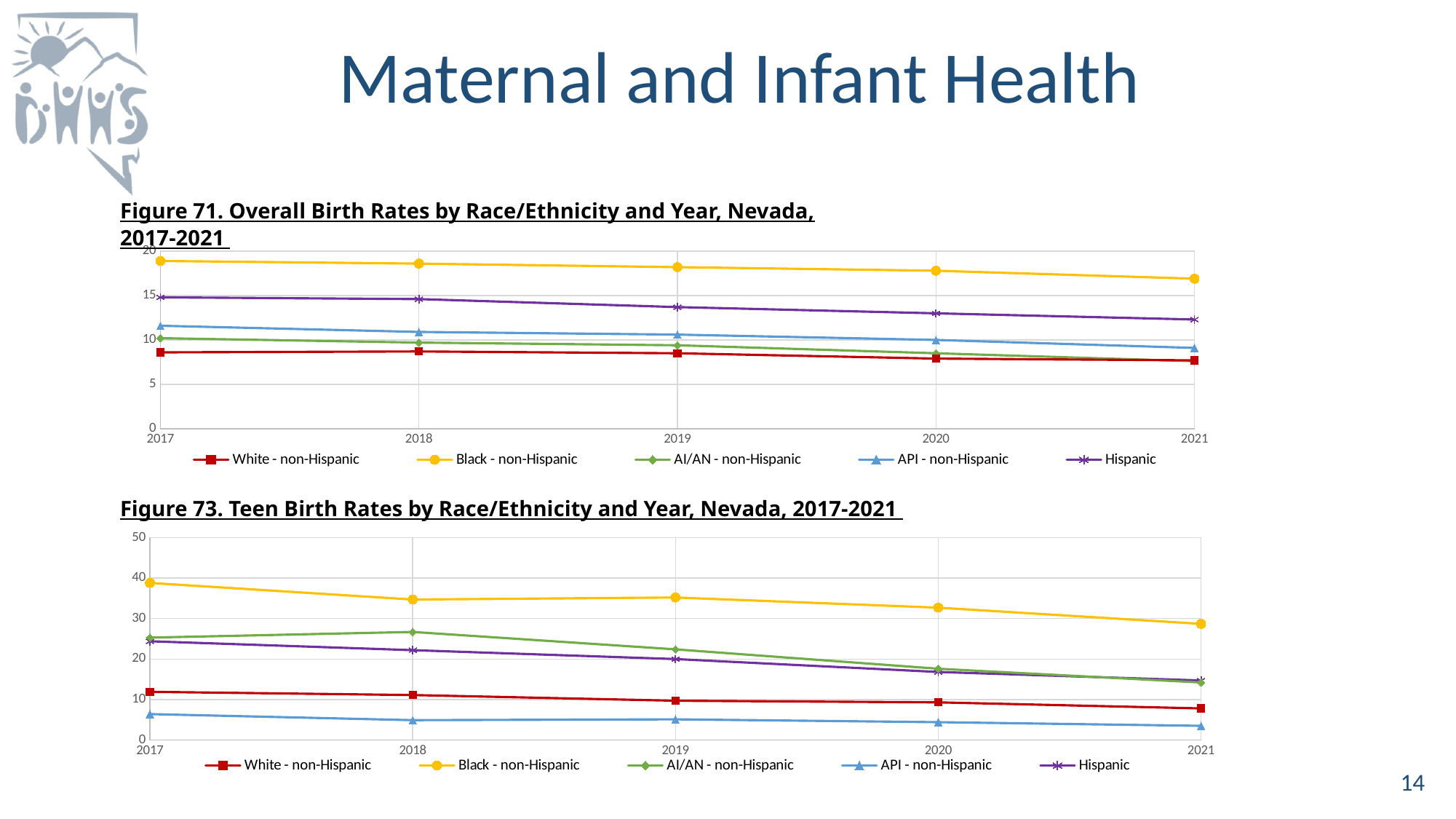
In Figure 71, which race/ethnicity group has the lowest birth rate in 2017? White - non-Hispanic What is the title of the lower chart on the slide? Figure 73. Teen Birth Rates by Race/Ethnicity and Year, Nevada, 2017-2021 What kind of chart is Figure 71? line chart In Figure 71, is the value for Black - non-Hispanic in 2017 greater or less than 15? greater How many series does the legend of Figure 73 list? 5 In Figure 73, which race/ethnicity group has the lowest teen birth rate in 2020? API - non-Hispanic In Figure 71, does the Hispanic birth rate rise or fall from 2017 to 2021? fall In Figure 71, which race/ethnicity group has the highest birth rate in 2019? Black - non-Hispanic In Figure 73, which is larger in 2018: the value for AI/AN - non-Hispanic or the value for White - non-Hispanic? AI/AN - non-Hispanic In Figure 71, is the value for API - non-Hispanic in 2021 greater or less than 10? less How many years are shown on the x axis of Figure 71? 5 In Figure 73, is the value for Black - non-Hispanic in 2017 greater or less than 30? greater